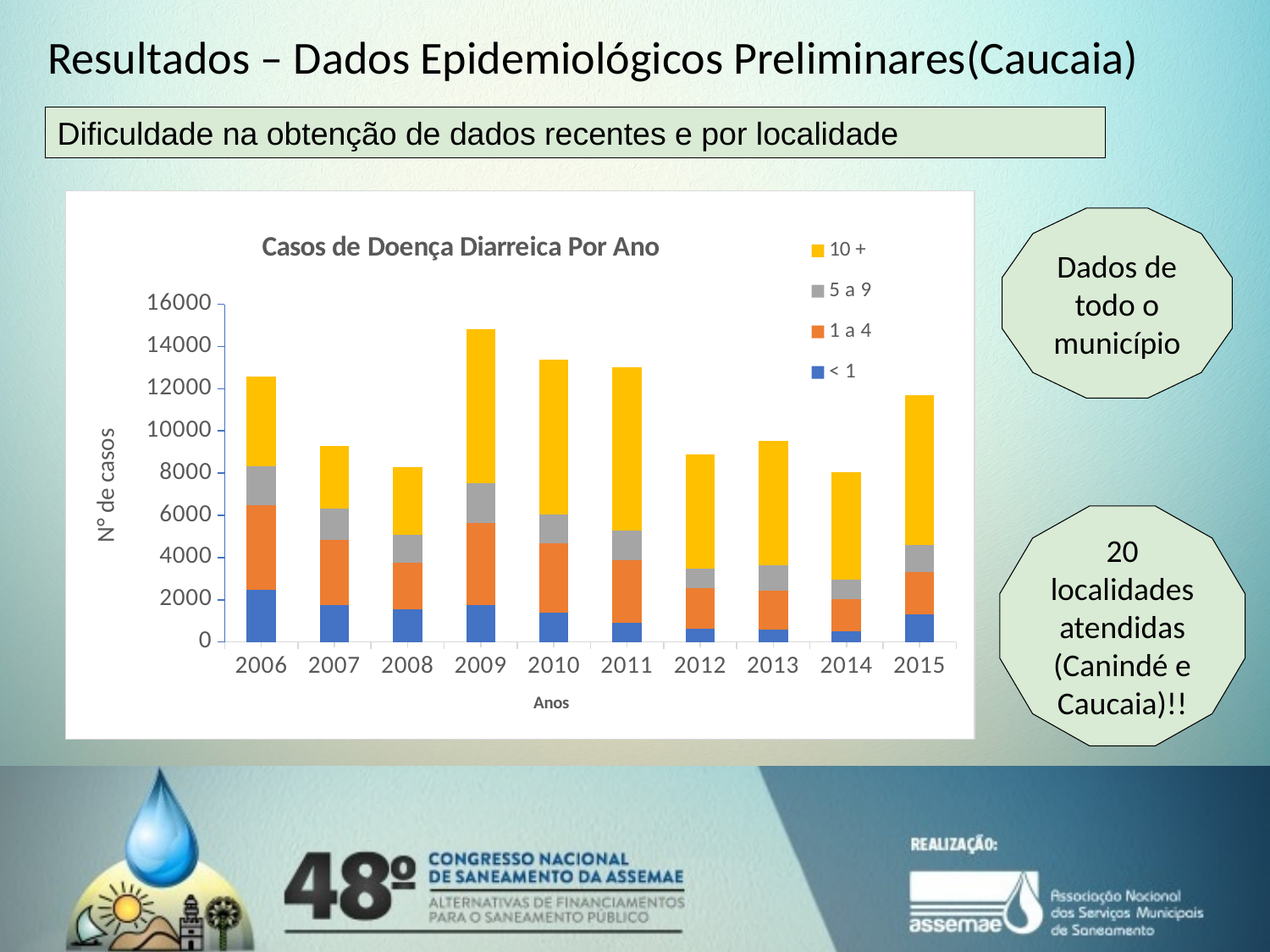
Which year has a larger total number of cases, 2009 or 2012? 2009 Which year has a larger total number of cases, 2010 or 2014? 2010 Is the total number of cases for 2009 greater or less than 14000? greater Is the total number of cases for 2015 greater or less than 10000? greater What label is shown on the y axis of the chart? N° de casos What is the title of the chart? Casos de Doença Diarreica Por Ano How many years are shown on the x axis of the chart? 10 Is the total number of cases for 2014 greater or less than 10000? less How many series does the chart legend list? 4 Which year has the highest total number of cases? 2009 What kind of chart is shown on the slide? Stacked bar chart